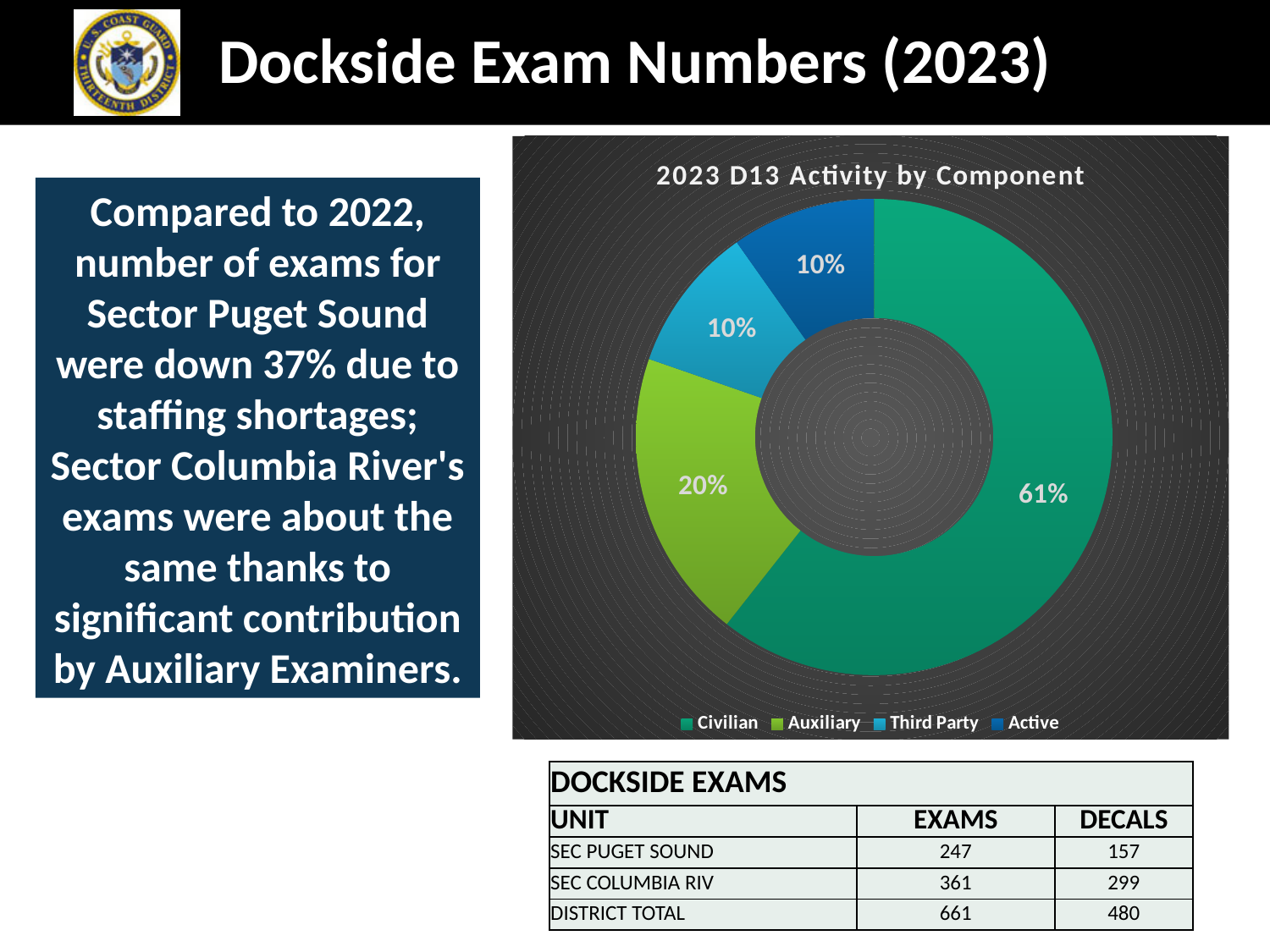
What share of 2023 D13 activity is attributed to Active? 10% Which has a larger share of 2023 D13 activity, Civilian or Auxiliary? Civilian What kind of chart is shown on the slide? doughnut chart What share of 2023 D13 activity is attributed to Auxiliary? 20% Which component has the largest share of 2023 D13 activity? Civilian What is the difference in percentage points between the Civilian and Auxiliary shares? 41 What share of 2023 D13 activity is attributed to Civilian? 61% How many entries does the legend of the chart list? 4 What is the title of the chart on the slide? 2023 D13 Activity by Component How many components are shown in the 2023 D13 Activity by Component chart? 4 What is the difference in percentage points between the Auxiliary and Active shares? 10